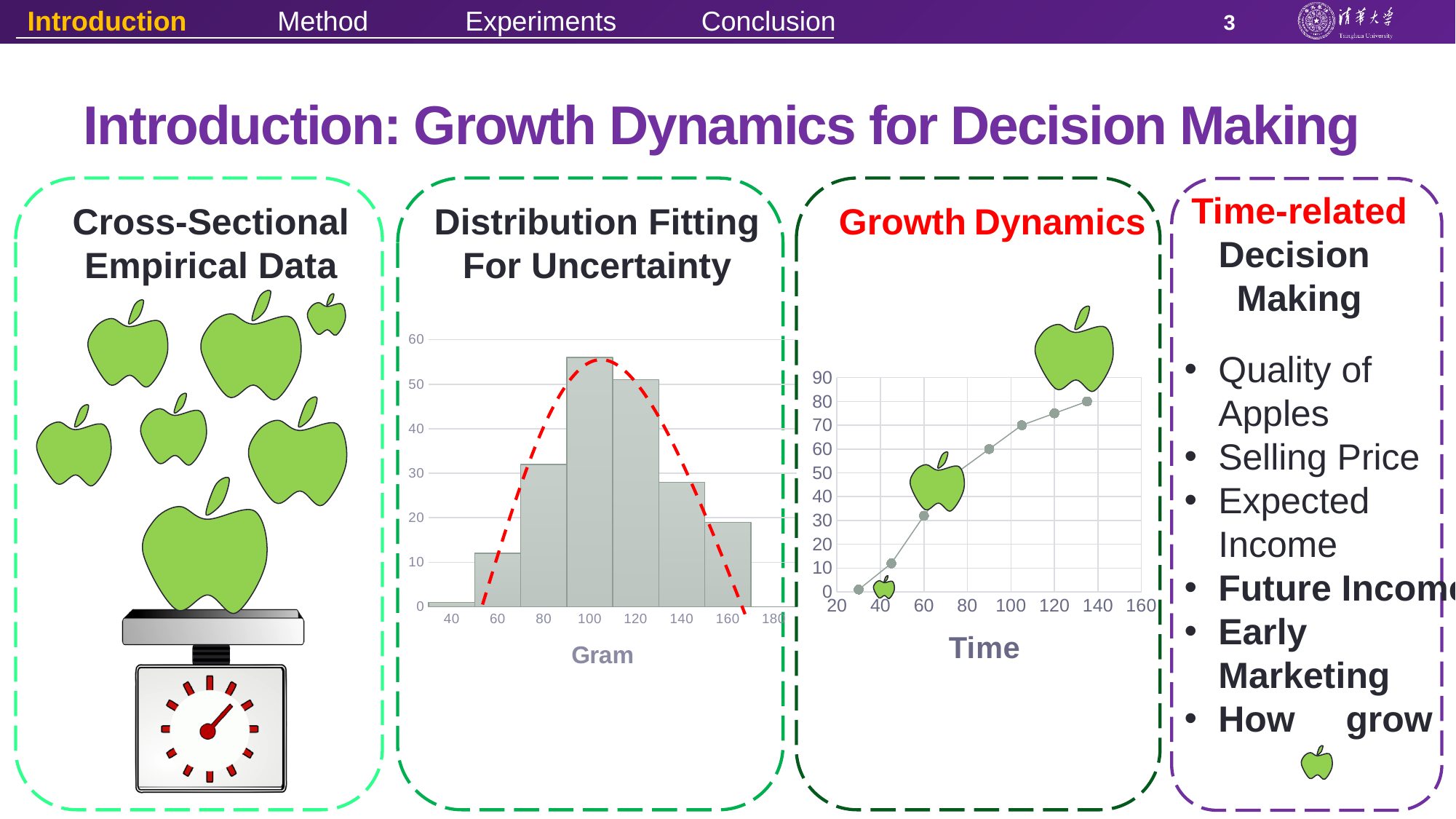
What kind of chart is shown in the 'Growth Dynamics' panel? line chart In the 'Distribution Fitting For Uncertainty' chart, is the bar for the 130–150 gram bin greater or less than 40? less What is the x-axis title of the 'Distribution Fitting For Uncertainty' chart? Gram In the 'Distribution Fitting For Uncertainty' chart, which bar is taller: the 90–110 bin or the 130–150 bin? 90–110 In the 'Growth Dynamics' chart, do the values rise or fall as time increases? rise In the 'Distribution Fitting For Uncertainty' chart, is the bar for the 90–110 gram bin greater or less than 50? greater In the 'Growth Dynamics' chart, is the value at time 135 greater or less than 70? greater What kind of chart is shown in the 'Distribution Fitting For Uncertainty' panel? bar chart (histogram) In the 'Distribution Fitting For Uncertainty' chart, which gram bin has the tallest bar? 90–110